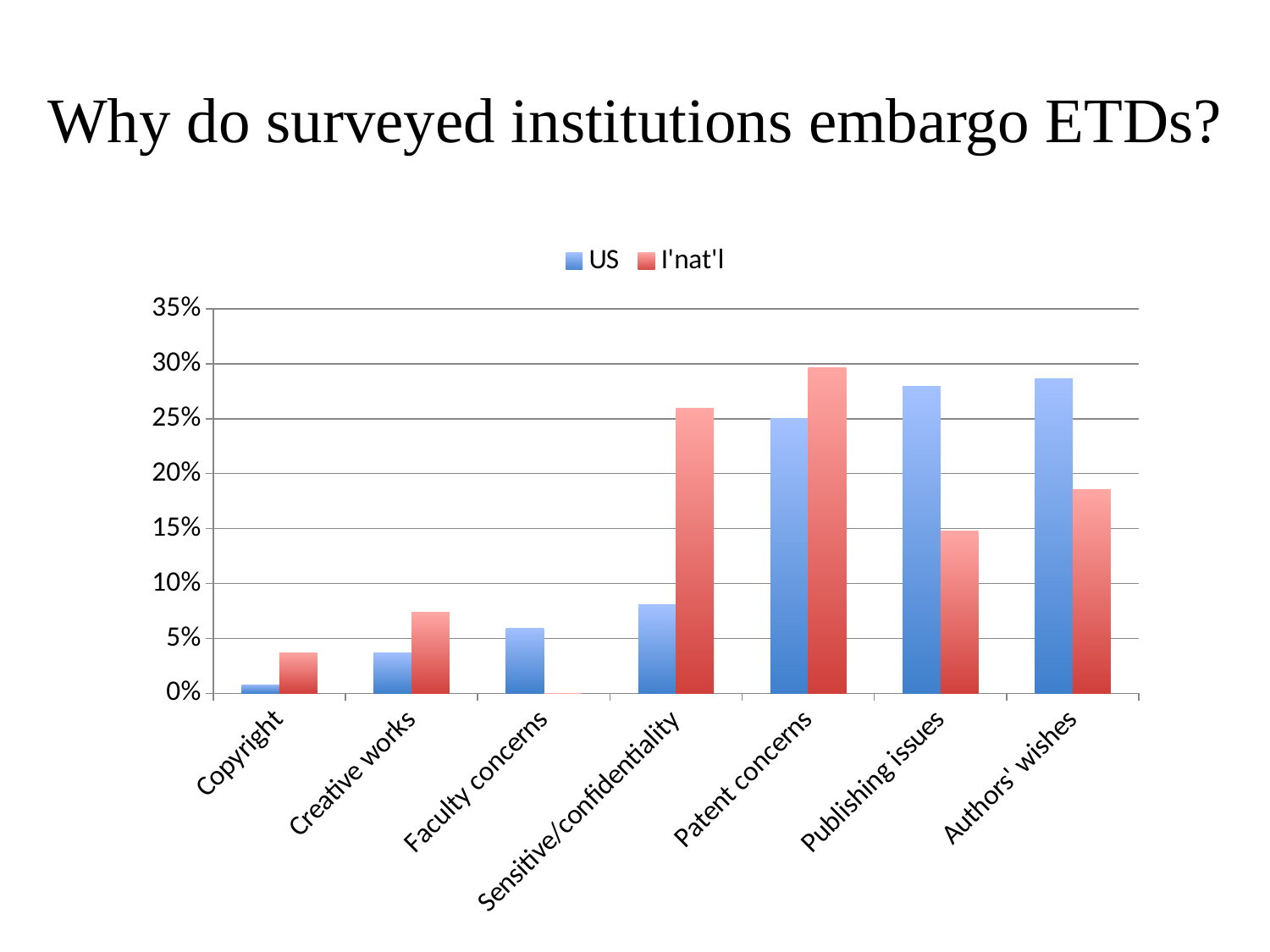
Which category has the lowest US value? Copyright Is the I'nat'l value for Sensitive/confidentiality greater or less than 25%? greater What kind of chart is shown on the slide? bar chart For Sensitive/confidentiality, which series has the larger value, US or I'nat'l? I'nat'l For Publishing issues, which series has the larger value, US or I'nat'l? US How many series does the legend list? 2 Which category has no I'nat'l bar shown? Faculty concerns Is the US value for Copyright greater or less than 5%? less Which category has the highest I'nat'l value? Patent concerns Is the US value for Patent concerns greater or less than 20%? greater How many categories are shown on the x axis? 7